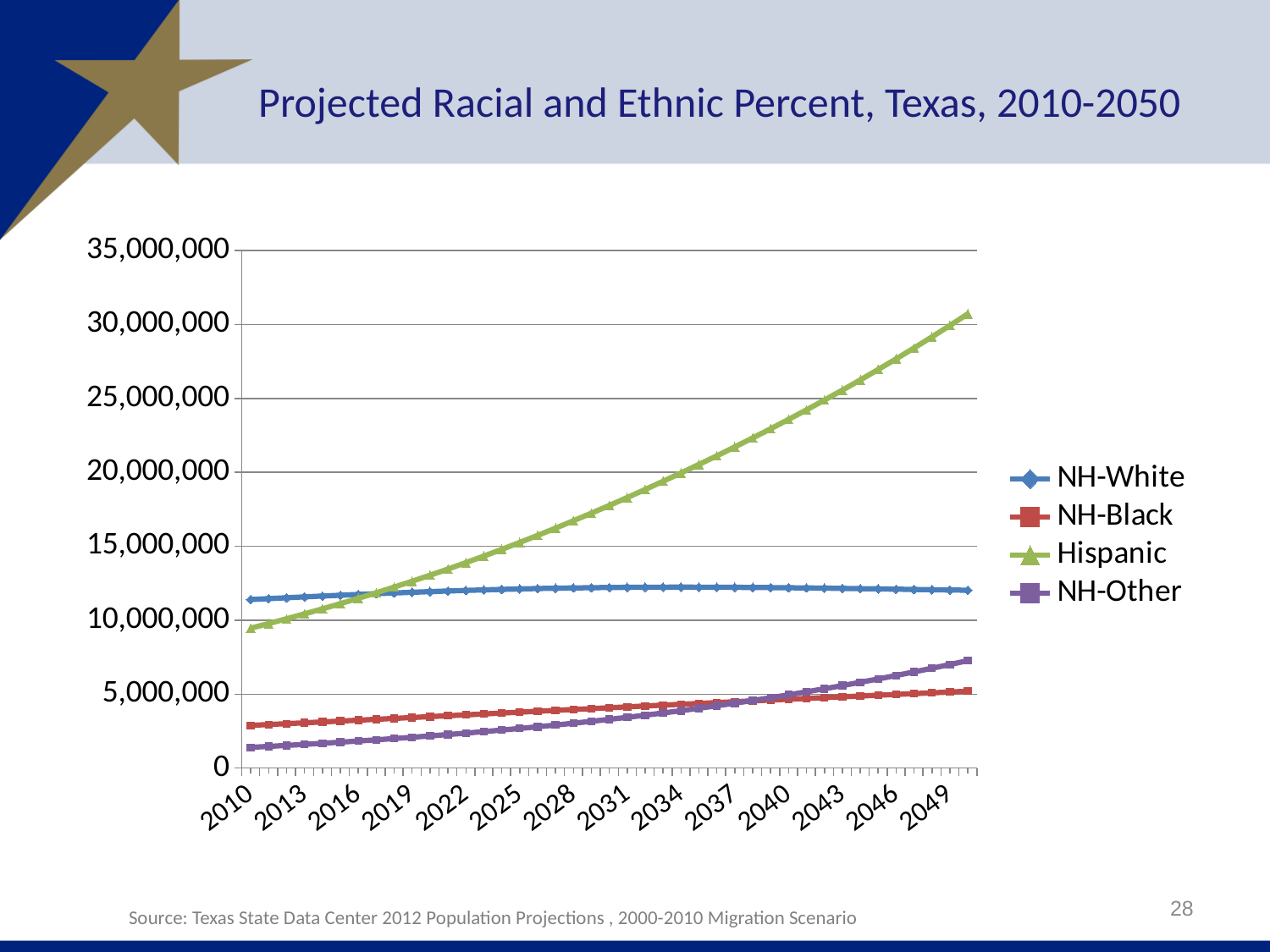
What kind of chart is shown on the slide? line chart Does the Hispanic series rise or fall from 2010 to 2049? rise Is the value for Hispanic in 2010 greater or less than 10,000,000? less Which is larger in 2049, NH-Black or NH-Other? NH-Other Which series is the lowest in 2010? NH-Other Which series is the highest in 2010? NH-White Is the value for Hispanic in 2040 greater or less than 20,000,000? greater Which is larger in 2010, NH-Black or NH-Other? NH-Black Is the value for NH-White in 2010 greater or less than 10,000,000? greater Which series is the highest in 2049? Hispanic How many series does the legend list? 4 What is the title of the chart? Projected Racial and Ethnic Percent, Texas, 2010-2050